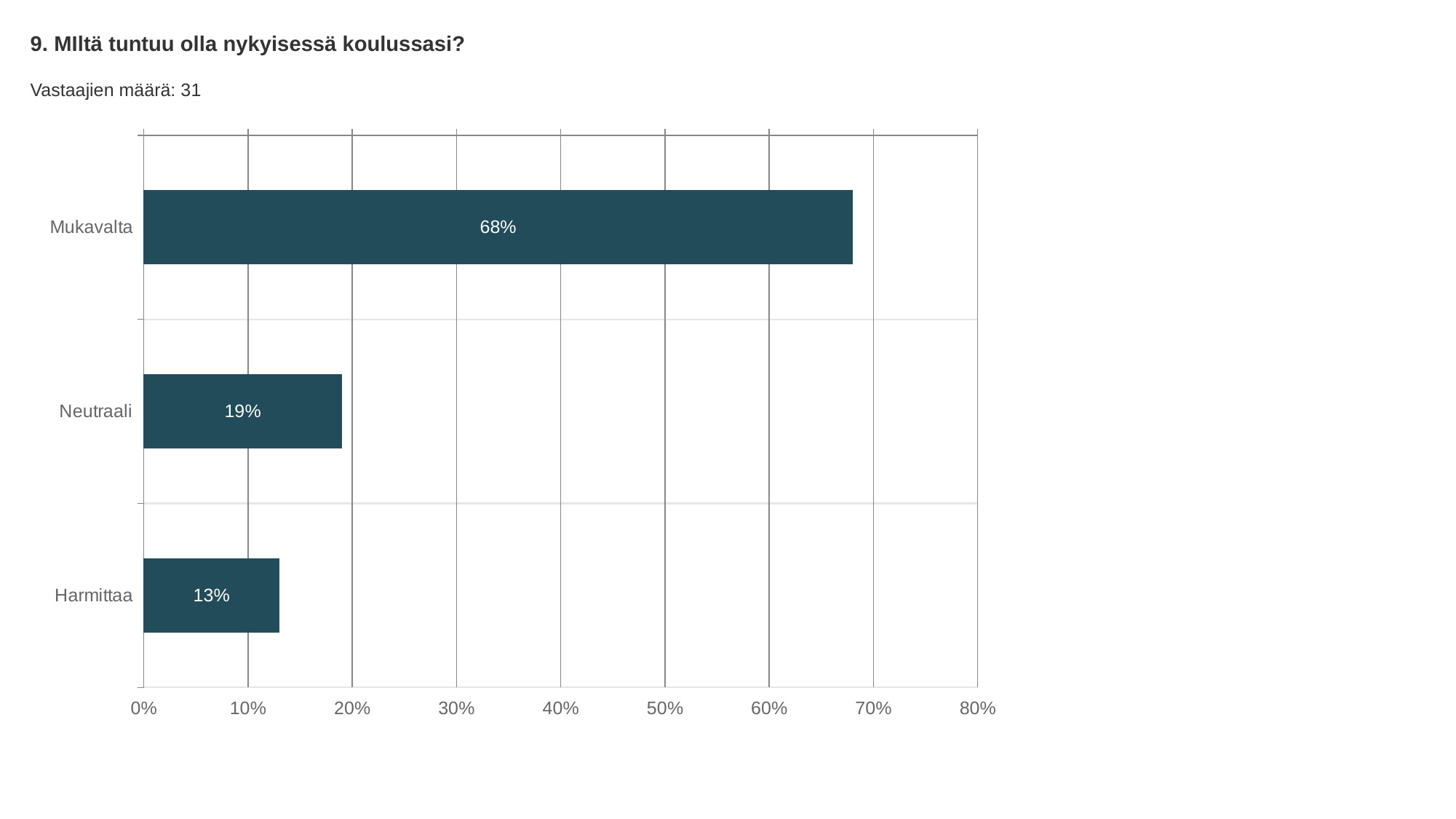
How many categories are shown in the chart? 3 Which category has the highest value? Mukavalta What is the difference between the values for Neutraali and Harmittaa? 6% Is the value for Mukavalta greater or less than 60%? greater What kind of chart is shown on the slide? bar chart What is the value for Mukavalta? 68% What is the difference between the values for Mukavalta and Neutraali? 49% Which is larger, the value for Neutraali or the value for Harmittaa? Neutraali What is the title of the chart? 9. MIltä tuntuu olla nykyisessä koulussasi? What is the value for Neutraali? 19% Which category has the lowest value? Harmittaa What is the value for Harmittaa? 13%